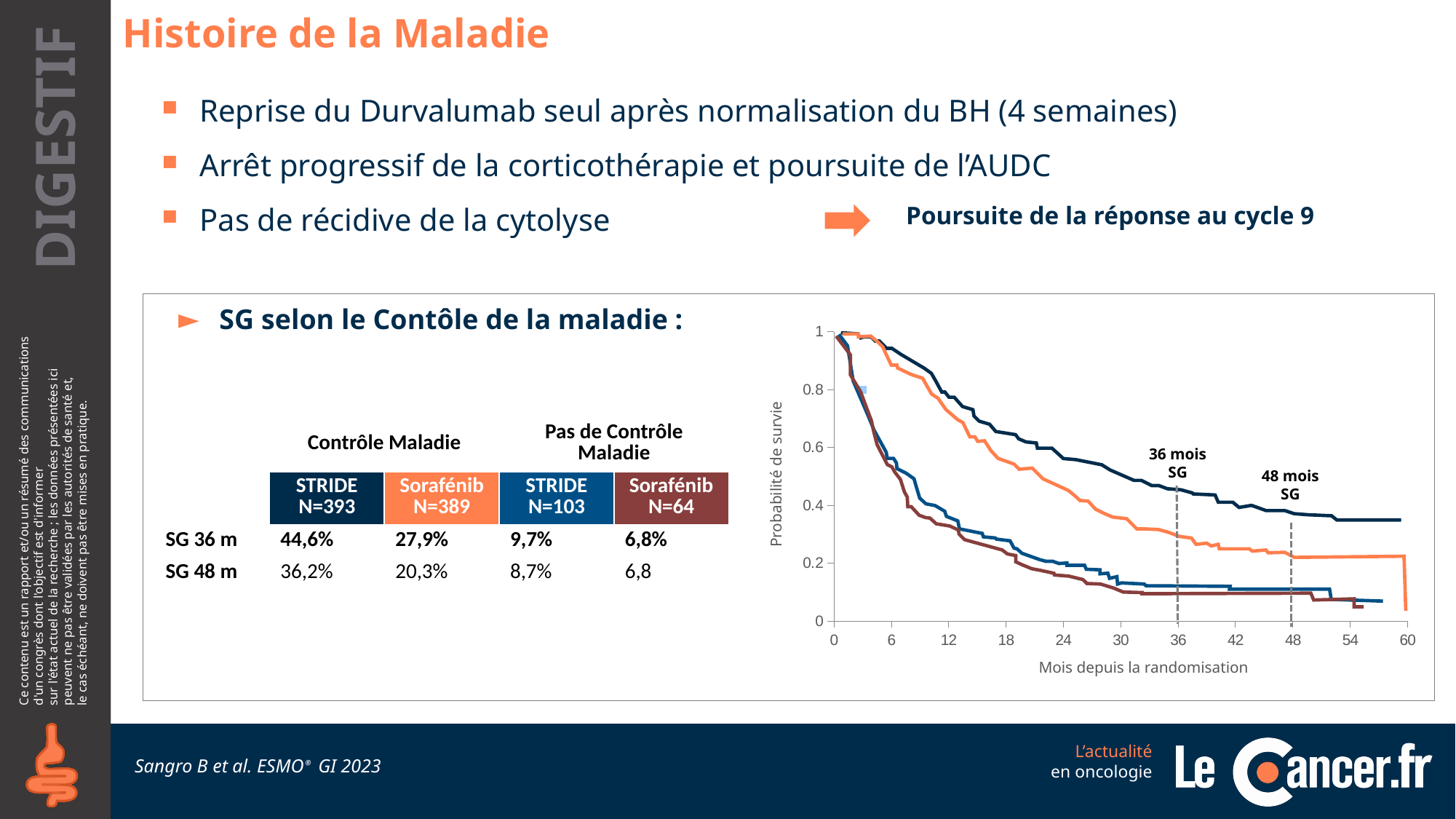
Which curve is highest at 36 months on the survival chart? the dark navy curve What is the title of the x axis of the survival chart? Mois depuis la randomisation What kind of chart is shown on the right of the slide? line chart On the survival chart, is the value of the orange curve at 48 months greater or less than 0.4? less Which curve is lowest at 36 months on the survival chart? the dark red curve What is the title of the y axis of the survival chart? Probabilité de survie At which two months are the dashed vertical lines drawn on the survival chart? 36 and 48 On the survival chart, is the value of the top (dark navy) curve at 36 months greater or less than 0.4? greater What is the largest tick value shown on the x axis of the survival chart? 60 On the survival chart, is the value of the dark red curve at 36 months greater or less than 0.2? less How many survival curves are plotted on the chart? 4 Do the curves on the survival chart rise or fall as months since randomisation increase? fall